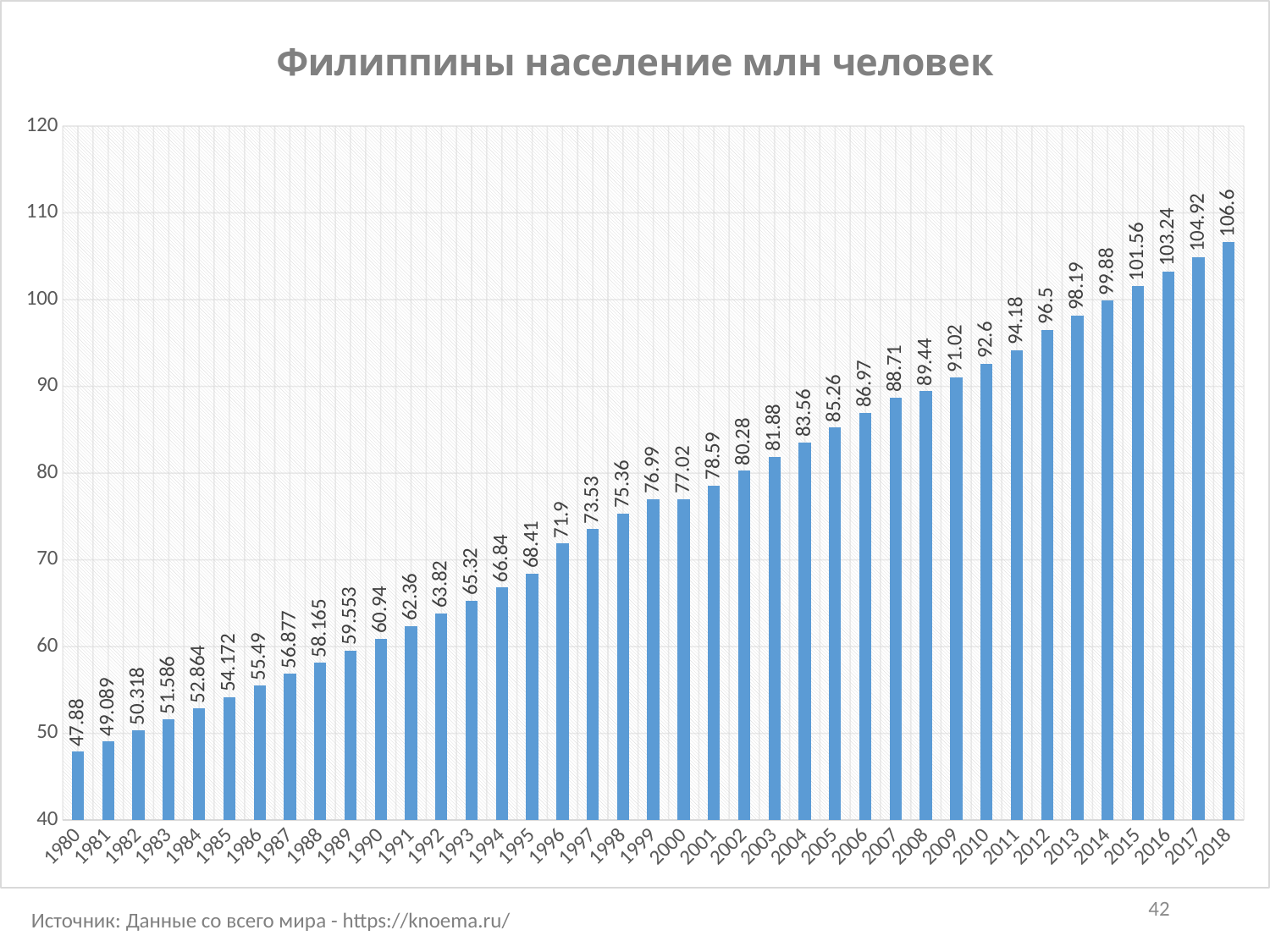
What is the population value shown for 1980? 47.88 How many years are shown on the chart? 39 What is the population value shown for 1990? 60.94 Which year has the highest population value on the chart? 2018 Is the value for 2005 greater or less than 80? greater Which year has a larger population value, 2005 or 1995? 2005 What is the population value shown for 2018? 106.6 What is the population value shown for 2000? 77.02 What is the difference between the population values for 2018 and 1980? 58.72 Which year has the lowest population value on the chart? 1980 What is the difference between the population values for 2000 and 1990? 16.08 What kind of chart is shown on the slide? bar chart